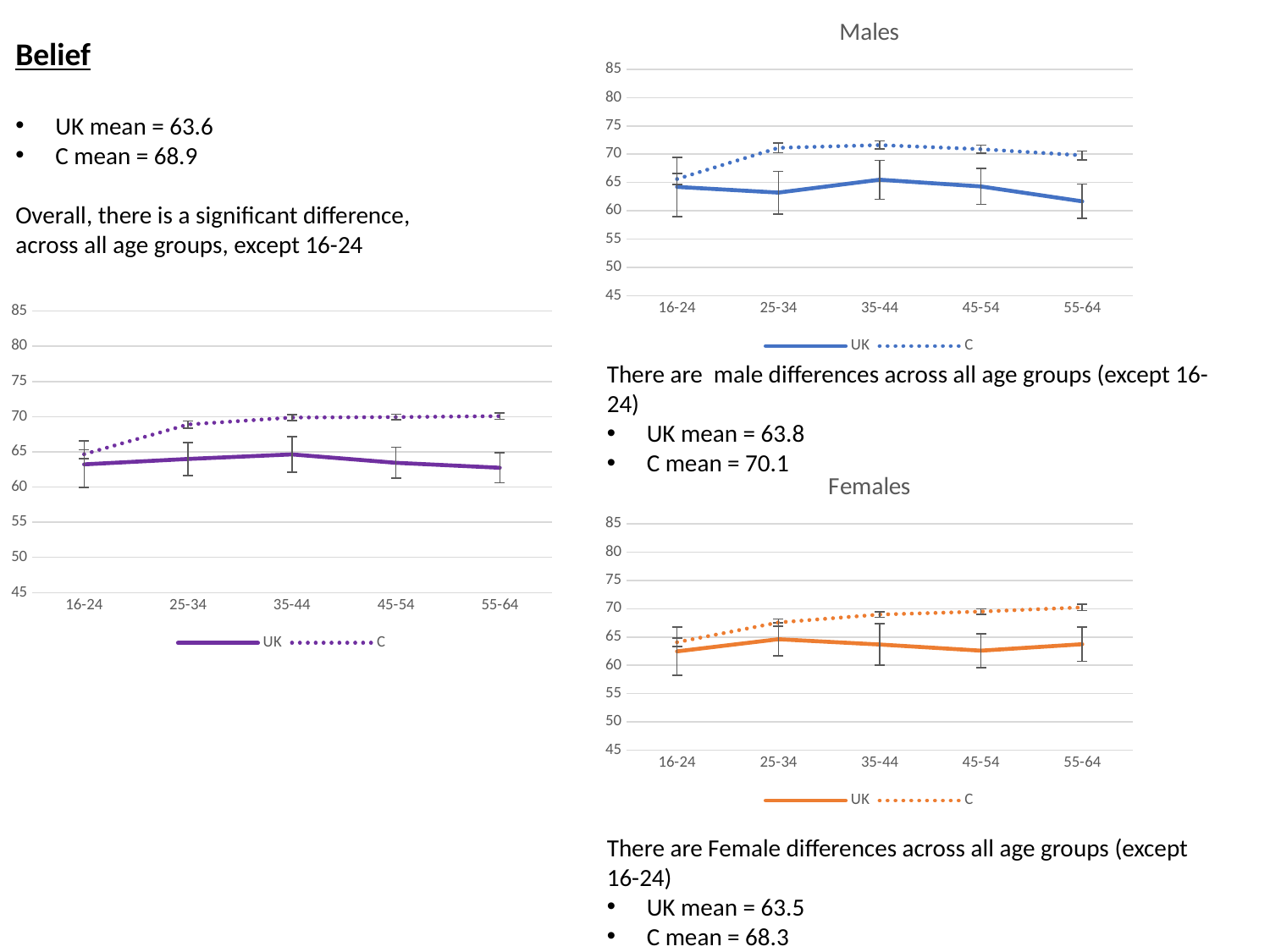
In the chart titled "Females", which age group has the lowest value for the C series? 16-24 In the left-hand chart, is the value for UK at 16-24 greater or less than 65? less In the chart titled "Females", which series has the larger value at 45-54, UK or C? C How many series does the legend of the left-hand chart list? 2 In the chart titled "Males", is the value for UK at 55-64 greater or less than 65? less In the left-hand chart, does the C series generally rise or fall from 16-24 to 55-64? rise What is the title of the chart at the bottom right of the slide? Females In the chart titled "Males", is the value for C at 35-44 greater or less than 70? greater What kind of chart is the chart titled "Males"? line chart How many age groups are shown on the x axis of the chart titled "Females"? 5 In the chart titled "Males", which series is shown with a dotted line? C